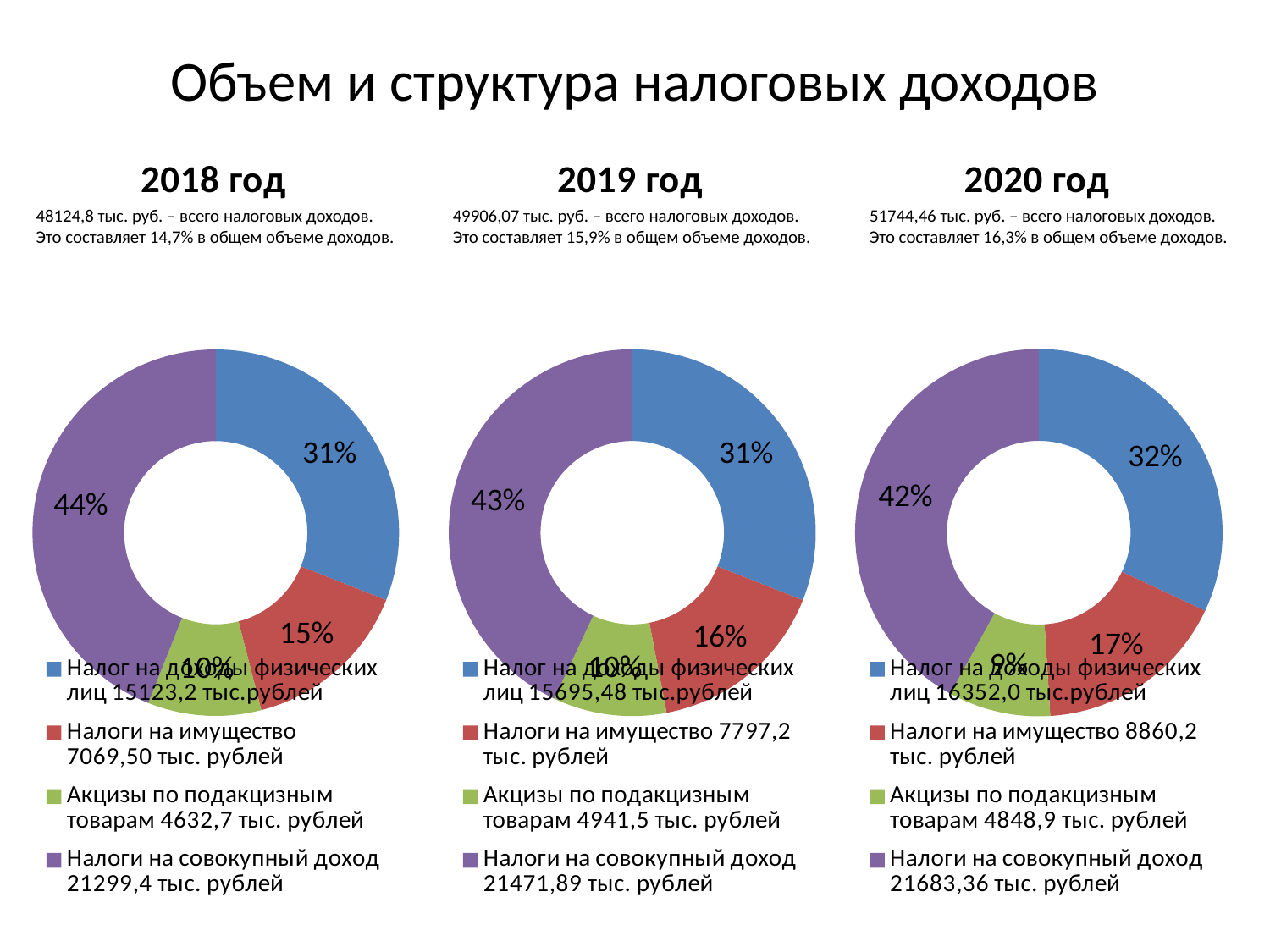
In the 2018 год chart, what share is shown for Налоги на совокупный доход? 44% In the 2019 год chart, what share is shown for Налоги на имущество? 16% In the 2020 год chart, what is the difference in percentage points between Налоги на совокупный доход and Налог на доходы физических лиц? 10 percentage points In the 2018 год chart, which category has the smallest slice? Акцизы по подакцизным товарам According to the legend of the 2018 год chart, what amount is given for Налоги на имущество? 7069,50 тыс. рублей In the 2020 год chart, what share is shown for Акцизы по подакцизным товарам? 9% In the 2020 год chart, what share is shown for Налог на доходы физических лиц? 32% What kind of chart is used for the 2018 год data? Doughnut chart Across the 2018, 2019 and 2020 charts, does the share of Налоги на совокупный доход rise or fall? Fall How many categories does the 2019 год chart show? 4 In the 2019 год chart, which is larger: Налог на доходы физических лиц or Налоги на имущество? Налог на доходы физических лиц In the 2020 год chart, which category has the largest slice? Налоги на совокупный доход